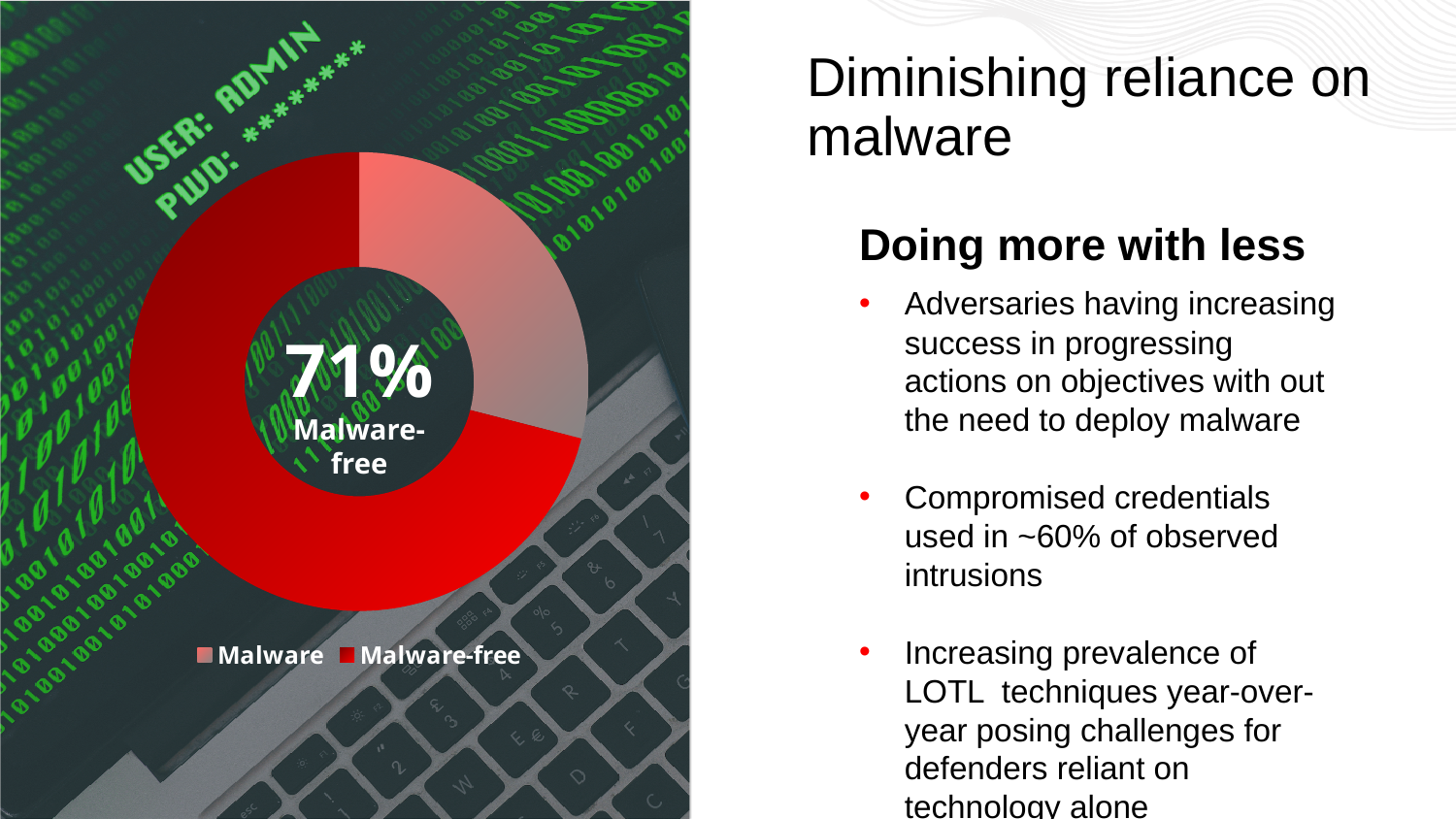
How many slices does the doughnut chart have? 2 What percentage is printed in the centre of the doughnut chart? 71% Which slice of the chart is the largest? Malware-free Which is larger, the Malware slice or the Malware-free slice? Malware-free Which slice of the chart is the smallest? Malware What share of the chart is labelled Malware-free? 71% How many entries does the chart legend list? 2 What are the two categories listed in the chart legend? Malware and Malware-free What colour is the Malware-free slice of the chart? Red What kind of chart is shown on the slide? Doughnut (pie) chart